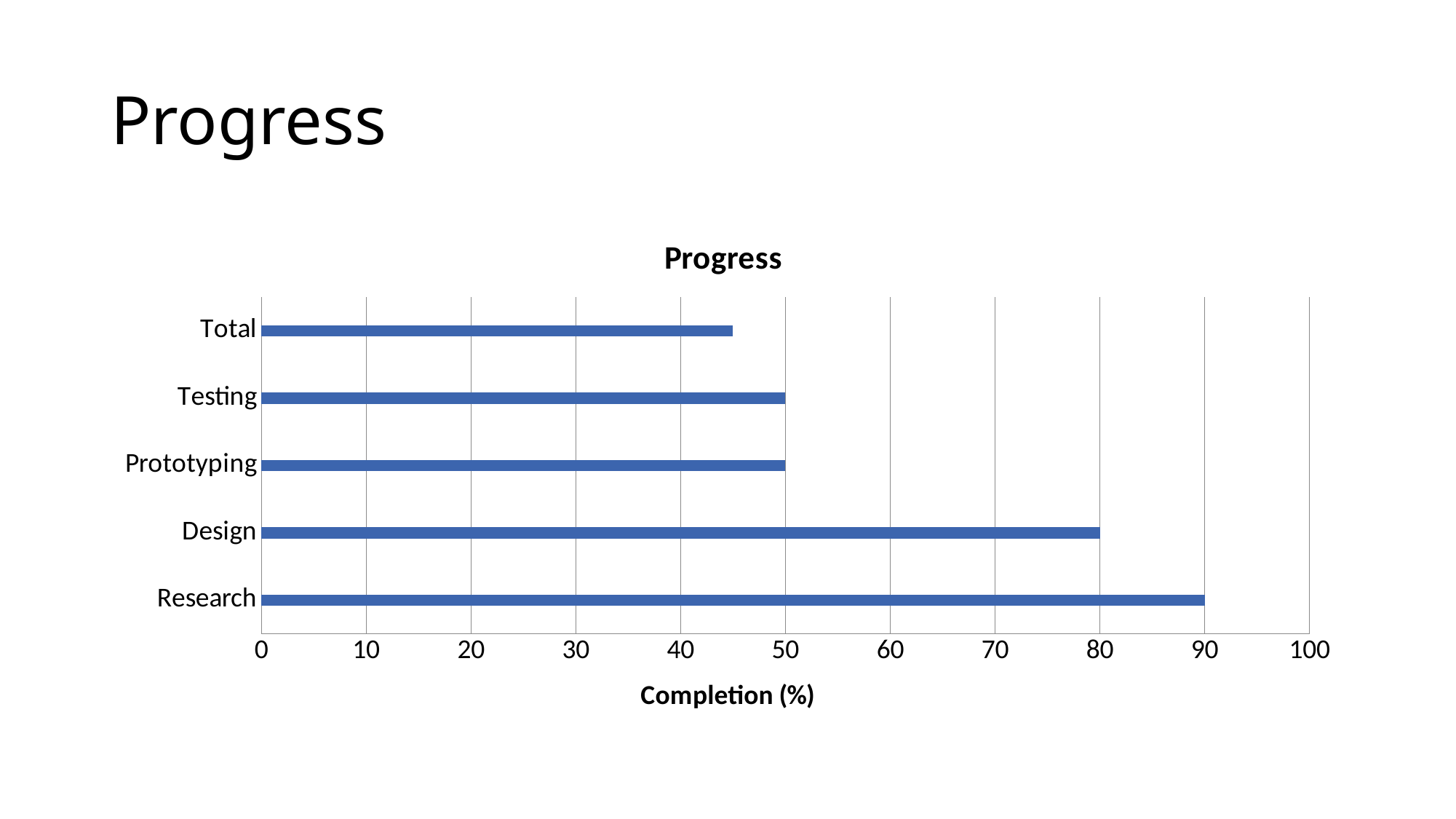
How many categories are plotted in the chart? 5 Is the value for Total greater or less than 50? less What is the completion value for Research? 90 Which category has the highest completion value? Research What is the difference between the completion values for Research and Design? 10 Which has a larger completion value, Design or Prototyping? Design What is the completion value for Design? 80 What is the label of the horizontal axis? Completion (%) Which category has the lowest completion value? Total What type of chart is shown on the slide? bar chart What is the completion value for Testing? 50 What is the title of the chart? Progress